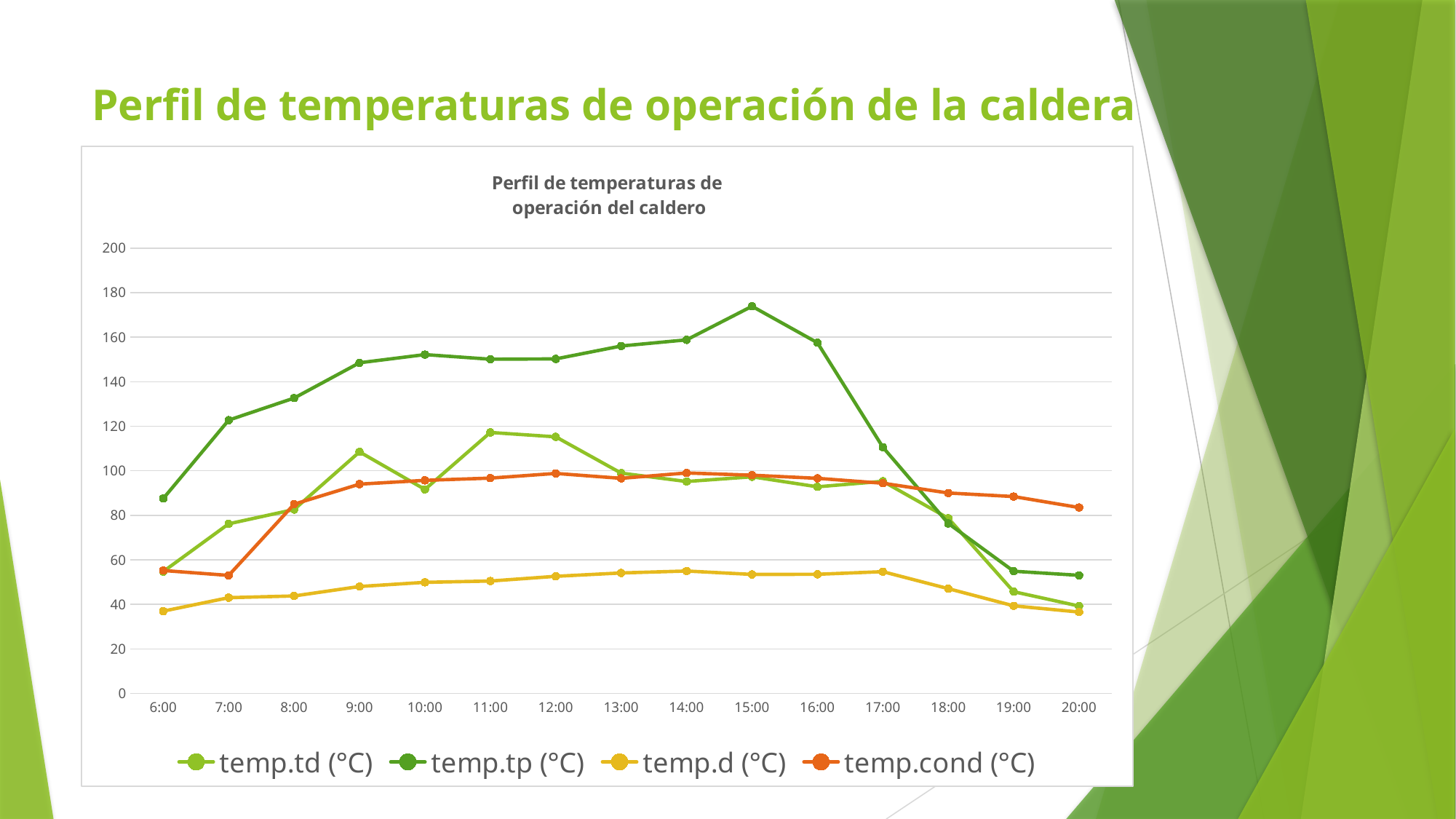
What is the title printed inside the chart area? Perfil de temperaturas de operación del caldero How many series does the legend list? 4 Does temp.cond (°C) rise or fall from 12:00 to 20:00? fall Is the value of temp.d (°C) at 6:00 greater or less than 40? less Is the value of temp.td (°C) at 11:00 greater or less than 100? greater Is the value of temp.tp (°C) at 15:00 greater or less than 160? greater How many time points are plotted along the x axis? 15 At which time is temp.td (°C) at its lowest value? 20:00 At 19:00, which is larger: temp.cond (°C) or temp.tp (°C)? temp.cond (°C) What kind of chart is shown on the slide? line chart At which time does temp.tp (°C) reach its highest value? 15:00 At 9:00, which is larger: temp.tp (°C) or temp.td (°C)? temp.tp (°C)